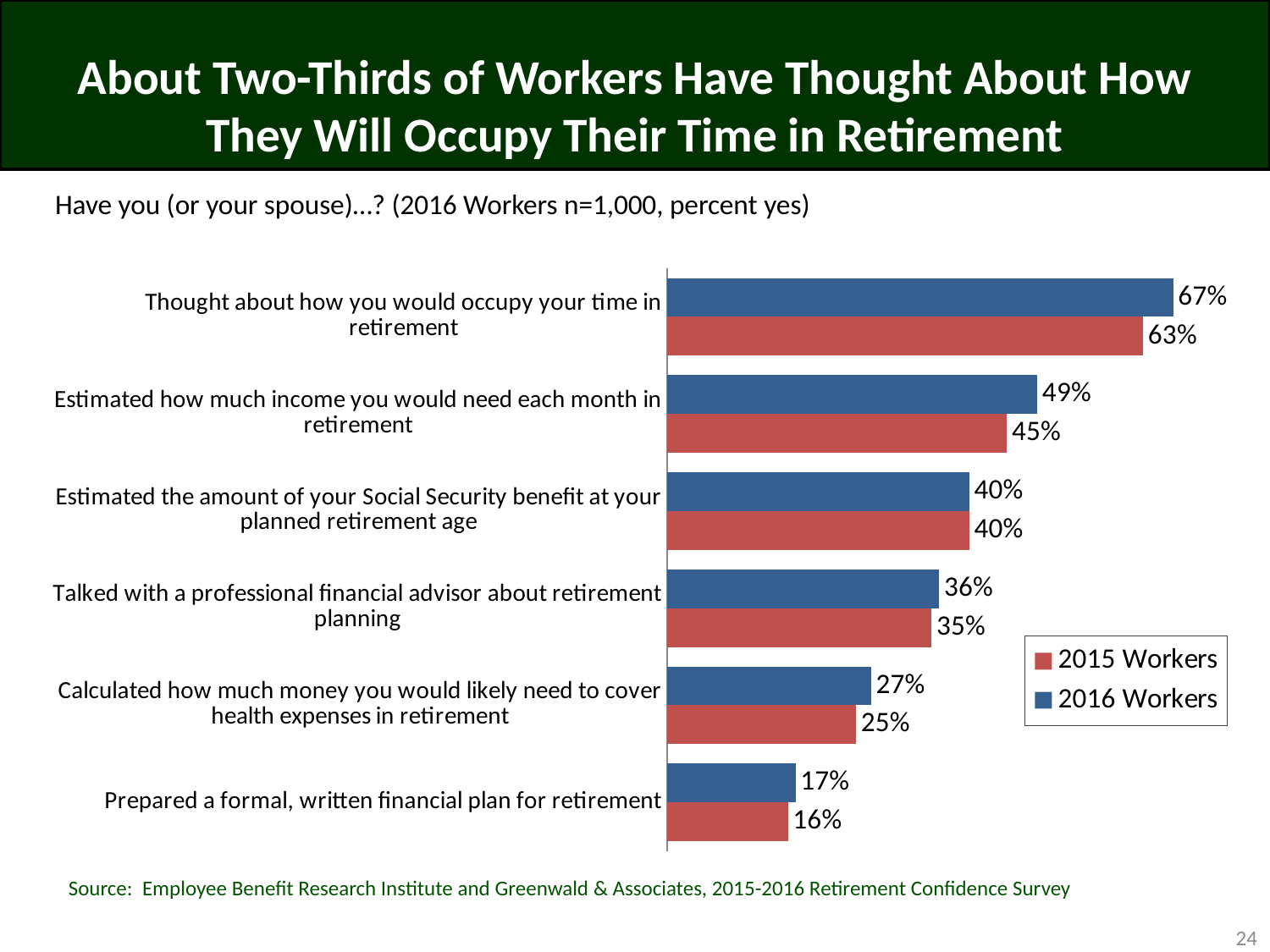
What percentage of 2016 Workers prepared a formal, written financial plan for retirement? 17% Which category has the lowest value for 2015 Workers? Prepared a formal, written financial plan for retirement What is the difference between the 2016 Workers and 2015 Workers values for 'Thought about how you would occupy your time in retirement'? 4 percentage points What percentage of 2015 Workers estimated how much income they would need each month in retirement? 45% Which colour represents 2015 Workers in the chart? Red How many categories are shown on the chart? 6 What percentage of 2015 Workers estimated the amount of their Social Security benefit at their planned retirement age? 40% What percentage of 2016 Workers have thought about how they would occupy their time in retirement? 67% What kind of chart is shown on the slide? Bar chart How many series does the legend list? 2 Which category has the highest value for 2016 Workers? Thought about how you would occupy your time in retirement For 'Calculated how much money you would likely need to cover health expenses in retirement', which is larger: the 2016 Workers value or the 2015 Workers value? 2016 Workers